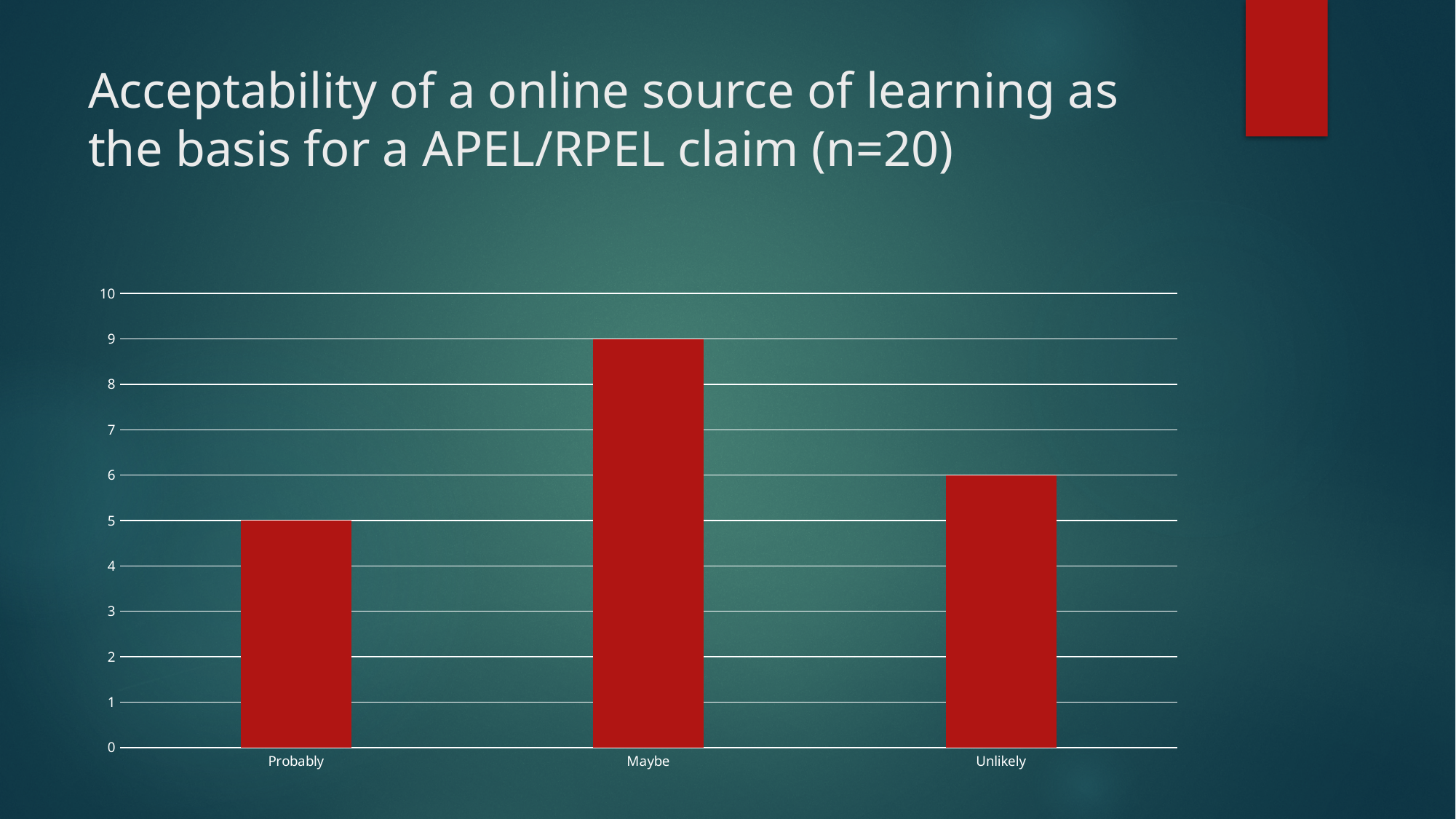
What is the difference between the values for Unlikely and Probably? 1 Which category has the lowest value? Probably Which category has the highest value? Maybe Which is larger, the value for Maybe or the value for Unlikely? Maybe What is the value for Unlikely? 6 What is the difference between the values for Maybe and Probably? 4 What is the value for Probably? 5 What is the sample size stated in the slide title? n=20 What kind of chart is shown on the slide? bar chart Is the value for Maybe greater or less than 8? greater What is the value for Maybe? 9 How many categories are shown on the x axis? 3